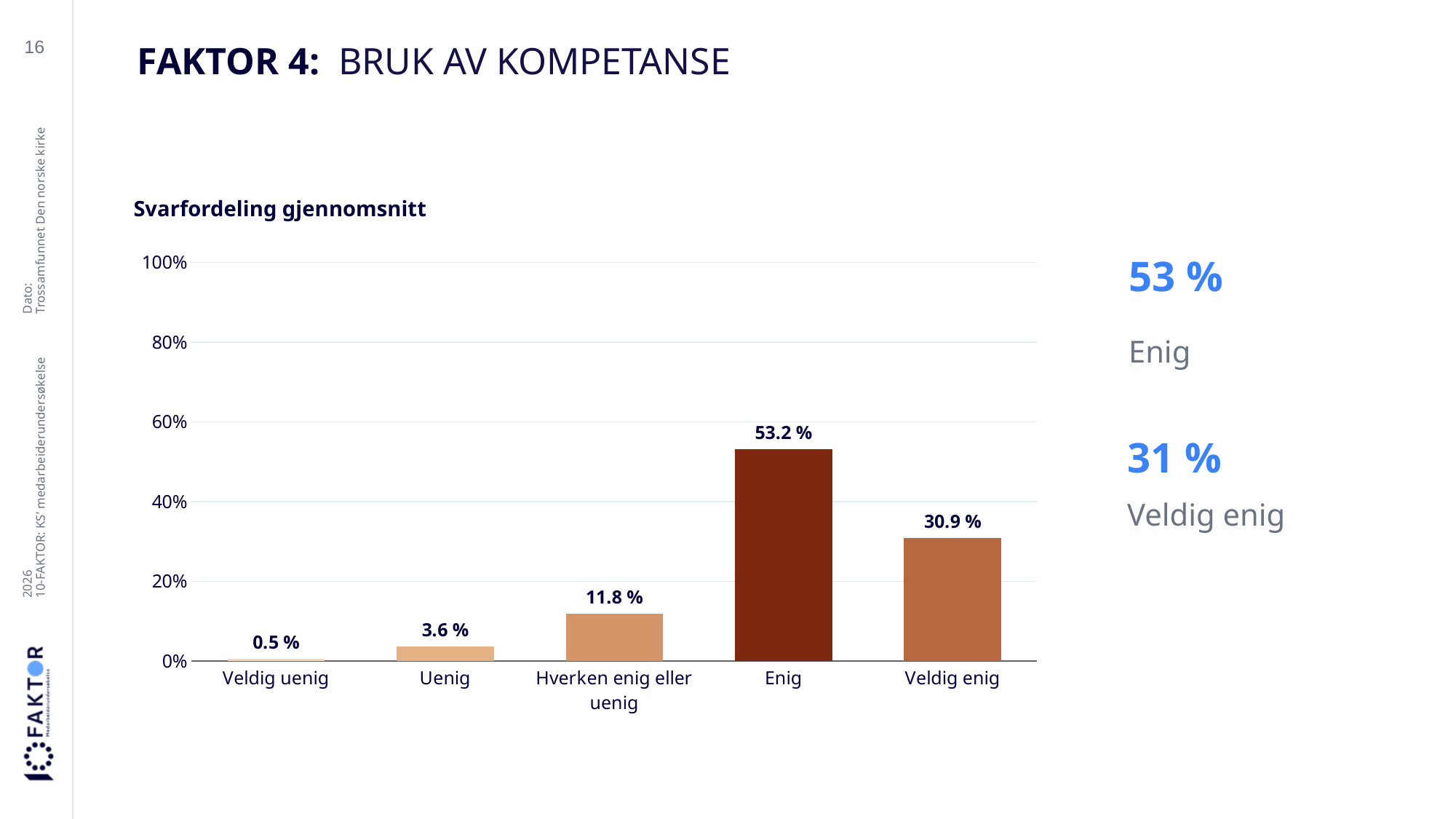
What is the value for Veldig uenig? 0.5 % Which category has the highest value? Enig What is the title of the chart? Svarfordeling gjennomsnitt What is the value for Veldig enig? 30.9 % What is the value for Hverken enig eller uenig? 11.8 % What is the value for Uenig? 3.6 % What is the difference between the values for Enig and Veldig enig? 22.3 % What kind of chart is shown on the slide? Bar chart Which category has the lowest value? Veldig uenig What is the value for Enig? 53.2 % Which is larger, the value for Uenig or the value for Hverken enig eller uenig? Hverken enig eller uenig How many categories are shown on the x axis? 5